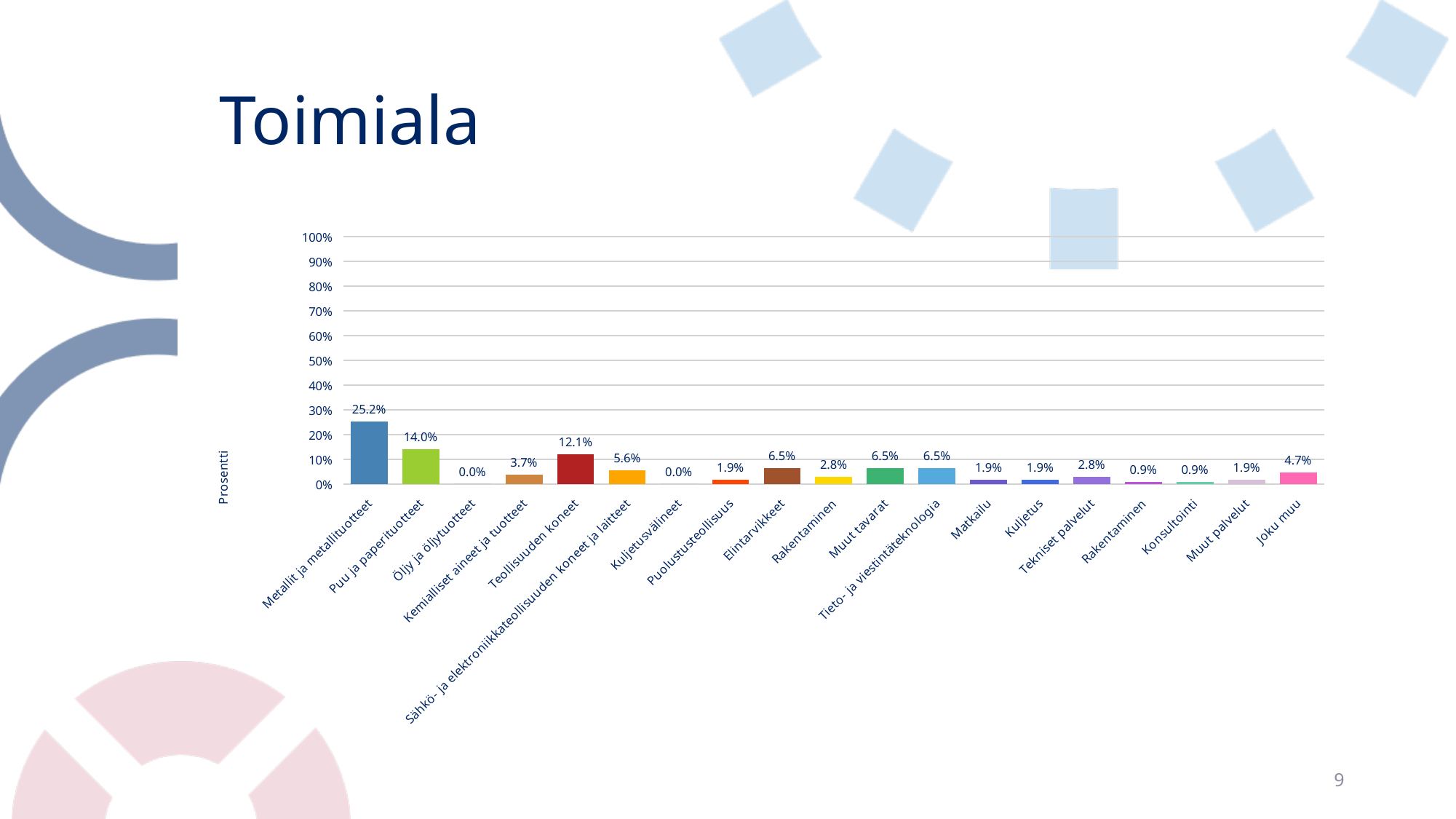
How many categories are shown on the x axis? 19 Which two categories have a value of 0.0%? Öljy ja öljytuotteet and Kuljetusvälineet What is the value for Teollisuuden koneet? 12.1% What is the value for Metallit ja metallituotteet? 25.2% What is the value for Sähkö- ja elektroniikkateollisuuden koneet ja laitteet? 5.6% What is the label of the y axis? Prosentti Is the value for Metallit ja metallituotteet greater or less than 20%? greater Which category has the highest value? Metallit ja metallituotteet What kind of chart is shown on the slide? Bar chart Which is larger, Teollisuuden koneet or Puu ja paperituotteet? Puu ja paperituotteet What is the difference between Metallit ja metallituotteet and Puu ja paperituotteet? 11.2% What is the value for Joku muu? 4.7%